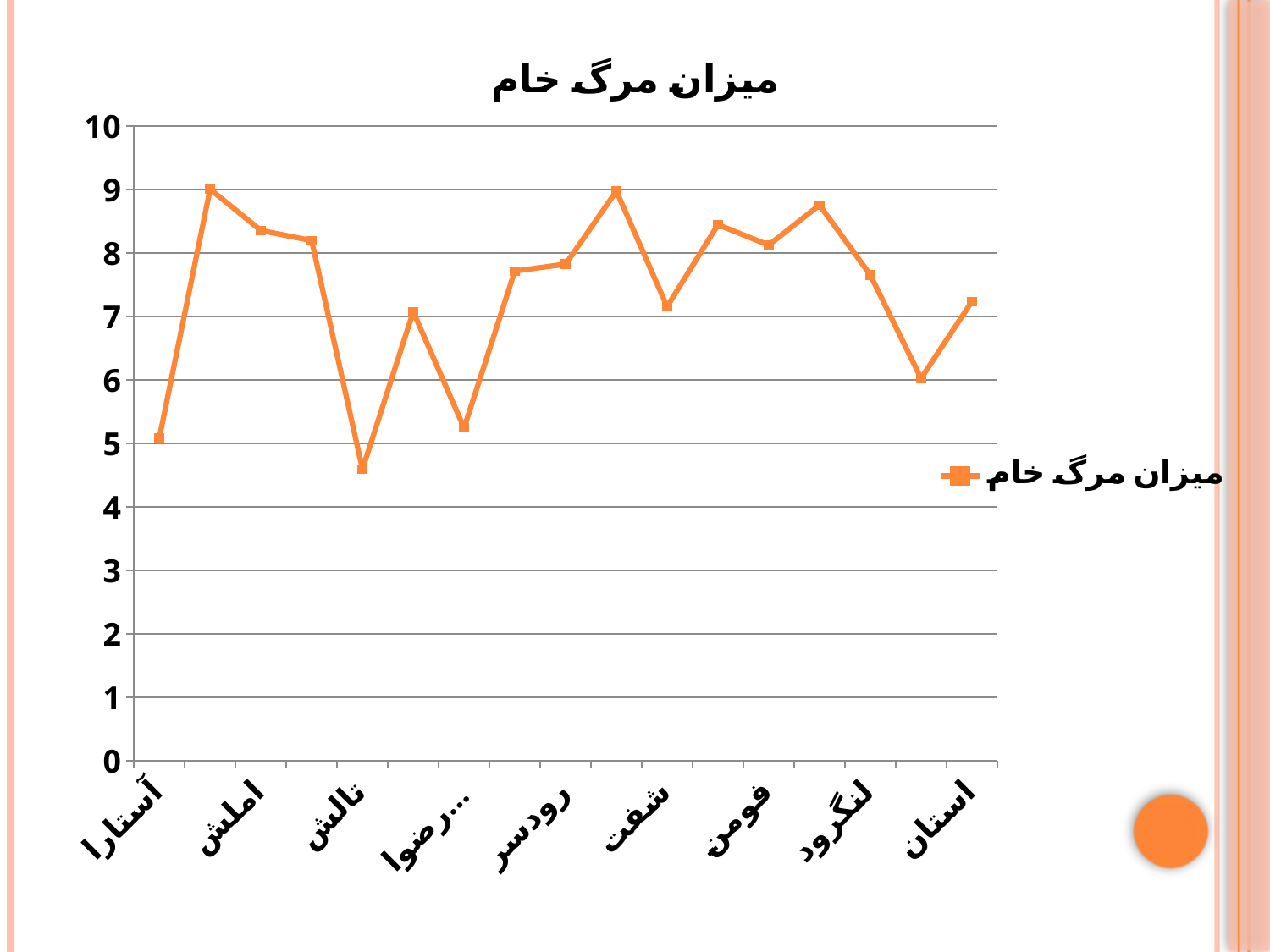
Is the value for استان greater or less than 8? less Is the value for رودسر greater or less than 7? greater Which has the larger value, املش or تالش? املش What is the title of the chart? میزان مرگ خام Is the value for املش greater or less than 8? greater Which labelled category has the lowest value? تالش What kind of chart is shown on the slide? line chart Which has the larger value, آستارا or رودسر? رودسر How many series does the legend list? 1